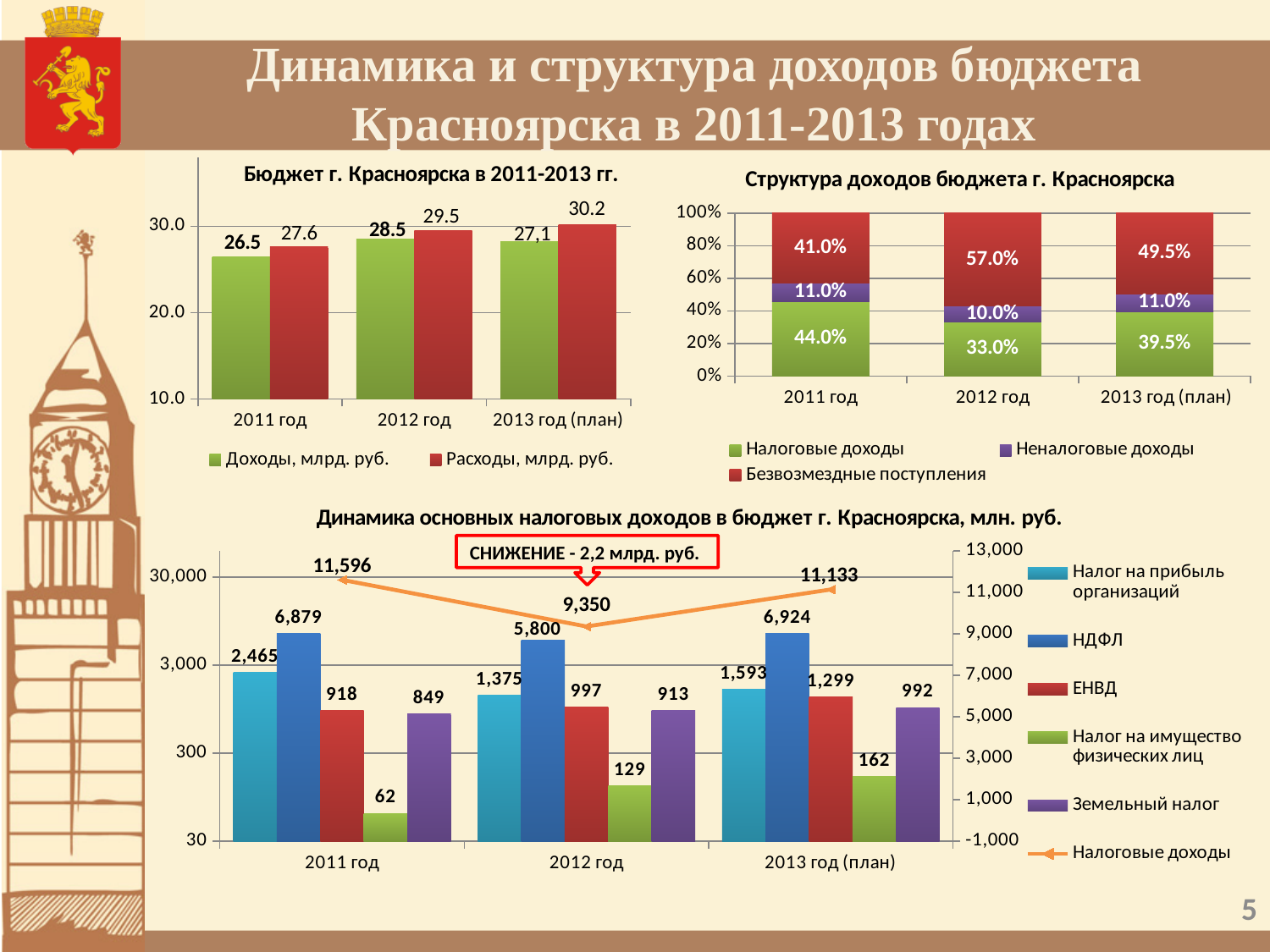
In the chart 'Динамика основных налоговых доходов в бюджет г. Красноярска, млн. руб.', which is larger in 2013 год (план): ЕНВД or Земельный налог? ЕНВД In the chart 'Структура доходов бюджета г. Красноярска', how many series does the legend list? 3 In the chart 'Бюджет г. Красноярска в 2011-2013 гг.', what is the value of Доходы, млрд. руб. for 2013 год (план)? 27,1 In the chart 'Структура доходов бюджета г. Красноярска', which year has the lowest share of Налоговые доходы? 2012 год In the chart 'Бюджет г. Красноярска в 2011-2013 гг.', which year has the highest value of Расходы, млрд. руб.? 2013 год (план) In the chart 'Структура доходов бюджета г. Красноярска', what is the share of Безвозмездные поступления in 2012 год? 57.0% In the chart 'Структура доходов бюджета г. Красноярска', what is the share of Налоговые доходы in 2013 год (план)? 39.5% In the chart 'Бюджет г. Красноярска в 2011-2013 гг.', what is the difference between Расходы and Доходы in 2011 год? 1.1 In the chart 'Динамика основных налоговых доходов в бюджет г. Красноярска, млн. руб.', what is the difference between Налог на прибыль организаций in 2011 год and 2012 год? 1,090 In the chart 'Динамика основных налоговых доходов в бюджет г. Красноярска, млн. руб.', what is the value of Налоговые доходы (the line) for 2011 год? 11,596 In the chart 'Бюджет г. Красноярска в 2011-2013 гг.', what is the value of Расходы, млрд. руб. for 2012 год? 29.5 In the chart 'Динамика основных налоговых доходов в бюджет г. Красноярска, млн. руб.', what is the value of НДФЛ for 2012 год? 5,800